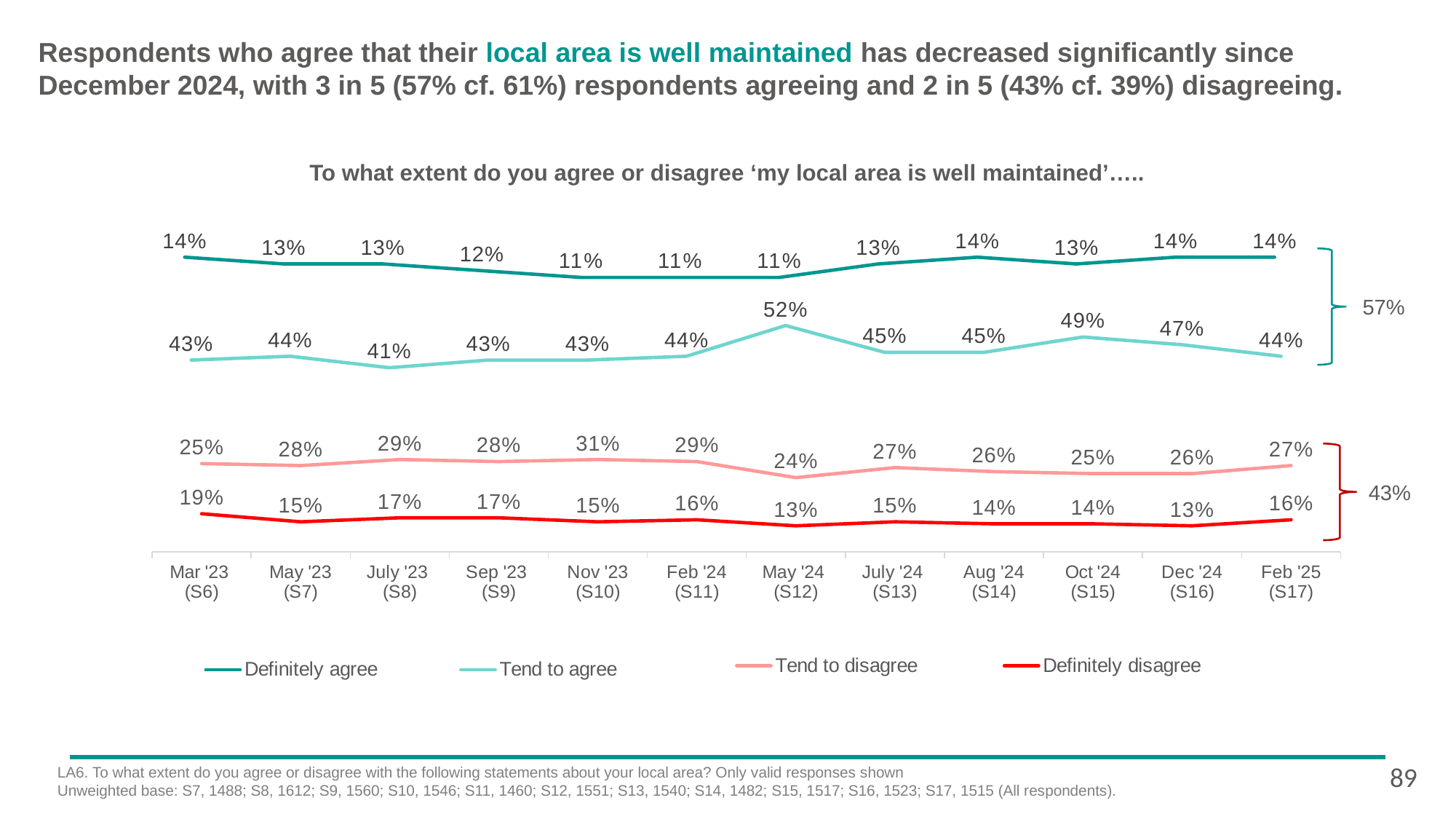
What is the value for 'Definitely disagree' in Mar '23 (S6)? 19% How many series does the legend list? 4 What is the value for 'Tend to agree' in May '24 (S12)? 52% What total percentage is shown by the bracket for the two agree series in Feb '25? 57% How many time points are shown on the x axis? 12 What kind of chart is shown on the slide? Line chart What is the value for 'Tend to disagree' in Nov '23 (S10)? 31% Which is larger in Feb '24 (S11): 'Tend to disagree' or 'Definitely disagree'? Tend to disagree What is the difference between the 'Tend to agree' values in Oct '24 (S15) and Feb '25 (S17)? 5 percentage points What is the value for 'Definitely agree' in Feb '25 (S17)? 14% In which period is the 'Tend to agree' value lowest? July '23 (S8) In which period is the 'Tend to agree' value highest? May '24 (S12)